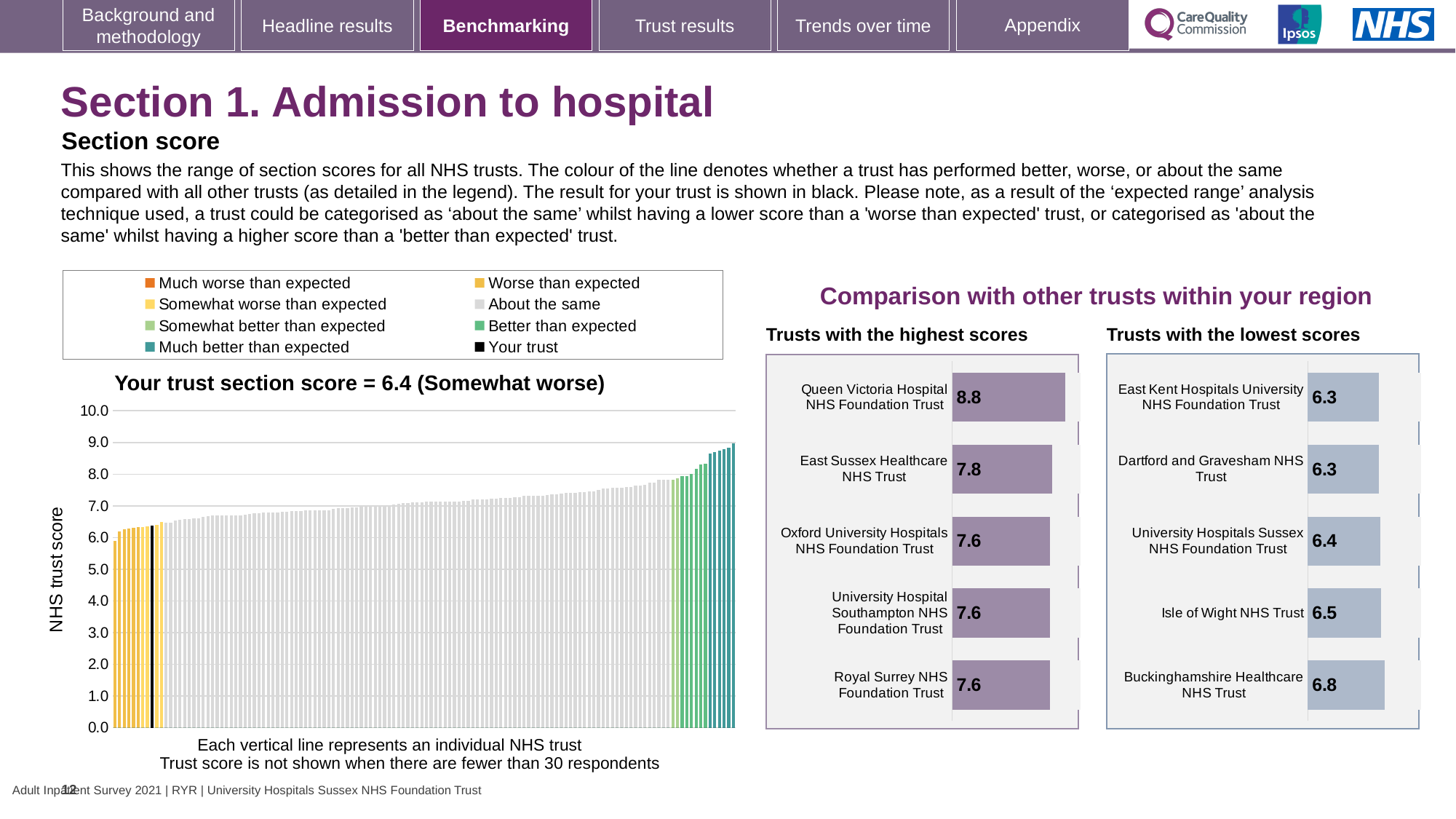
In the 'Trusts with the highest scores' chart, which trust has the highest score? Queen Victoria Hospital NHS Foundation Trust In the 'Trusts with the lowest scores' chart, which trust has the highest score? Buckinghamshire Healthcare NHS Trust In the 'Trusts with the highest scores' chart, what is the difference between the scores of Queen Victoria Hospital NHS Foundation Trust and East Sussex Healthcare NHS Trust? 1.0 In the 'Trusts with the lowest scores' chart, what is the score for Buckinghamshire Healthcare NHS Trust? 6.8 In the 'Trusts with the lowest scores' chart, which has the larger score: Isle of Wight NHS Trust or University Hospitals Sussex NHS Foundation Trust? Isle of Wight NHS Trust In the 'Trusts with the highest scores' chart, what is the score for Queen Victoria Hospital NHS Foundation Trust? 8.8 In the 'Your trust section score' chart, is the value of the highest bar greater or less than 8.0? greater In the 'Your trust section score' chart, what is the section score for your trust? 6.4 In the 'Your trust section score' chart, how many entries does the legend list? 8 In the 'Trusts with the highest scores' chart, how many trusts are shown? 5 In the 'Your trust section score' chart, what is the label on the vertical axis? NHS trust score In the 'Your trust section score' chart, what kind of chart is shown? bar chart